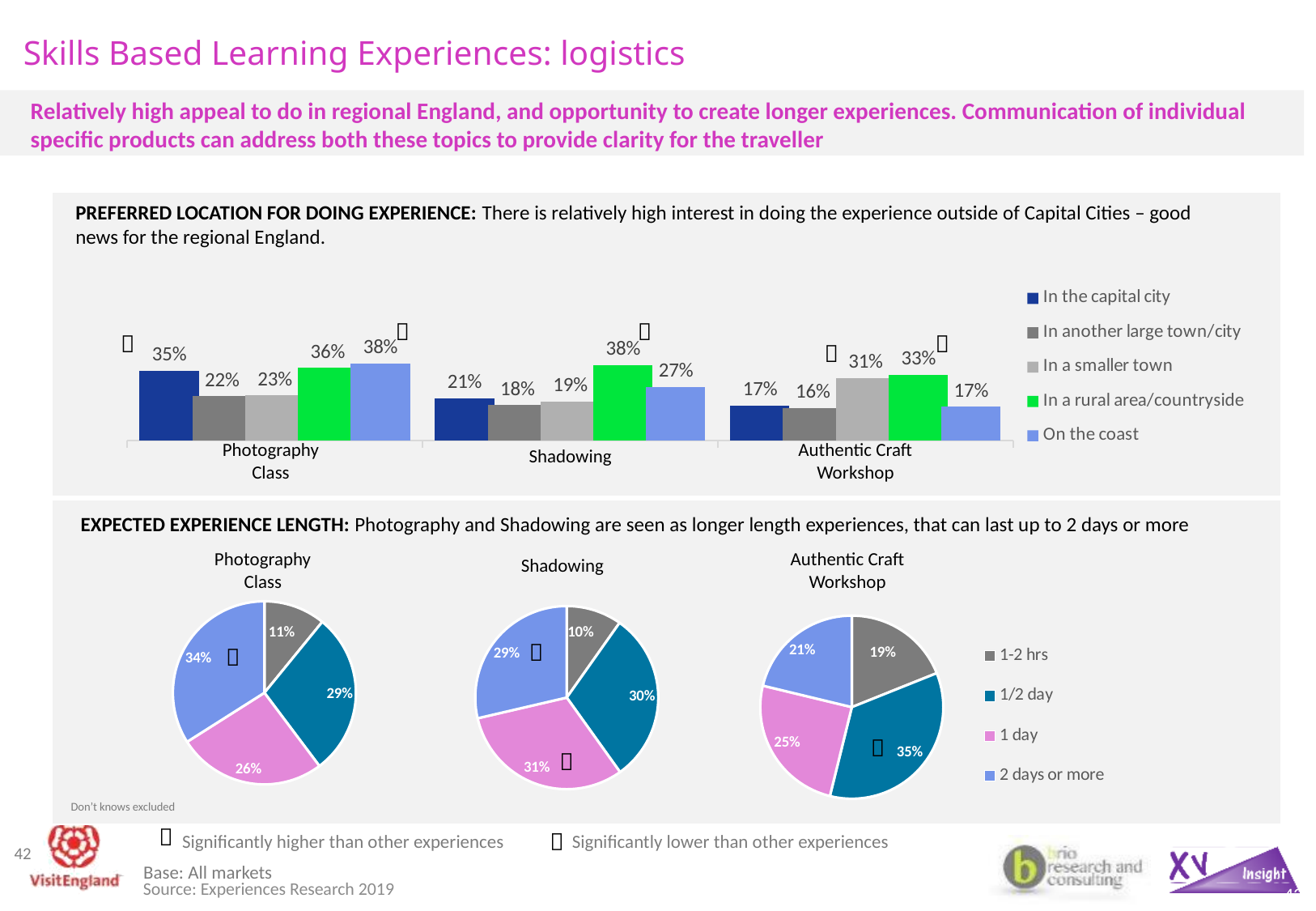
In the Authentic Craft Workshop pie chart, which experience length has the largest share? 1/2 day In the preferred location bar chart, what is the value for Authentic Craft Workshop in a smaller town? 31% In the preferred location bar chart, which is larger: Shadowing in the capital city or Shadowing on the coast? Shadowing on the coast In the preferred location bar chart, what is the value for Shadowing in a rural area/countryside? 38% In the preferred location bar chart, what is the difference between the 'On the coast' values for Photography Class and Shadowing? 11% In the Shadowing pie chart, what is the share for '1-2 hrs'? 10% In the preferred location bar chart, which location has the highest value for Photography Class? On the coast In the Photography Class pie chart for expected experience length, what share is '2 days or more'? 34% In the preferred location bar chart, what percentage of respondents would do a Photography Class in the capital city? 35% What kind of chart is used to show the preferred location for doing the experience? Bar chart How many series does the legend of the preferred location bar chart list? 5 In the preferred location bar chart, which location has the lowest value for Authentic Craft Workshop? In another large town/city